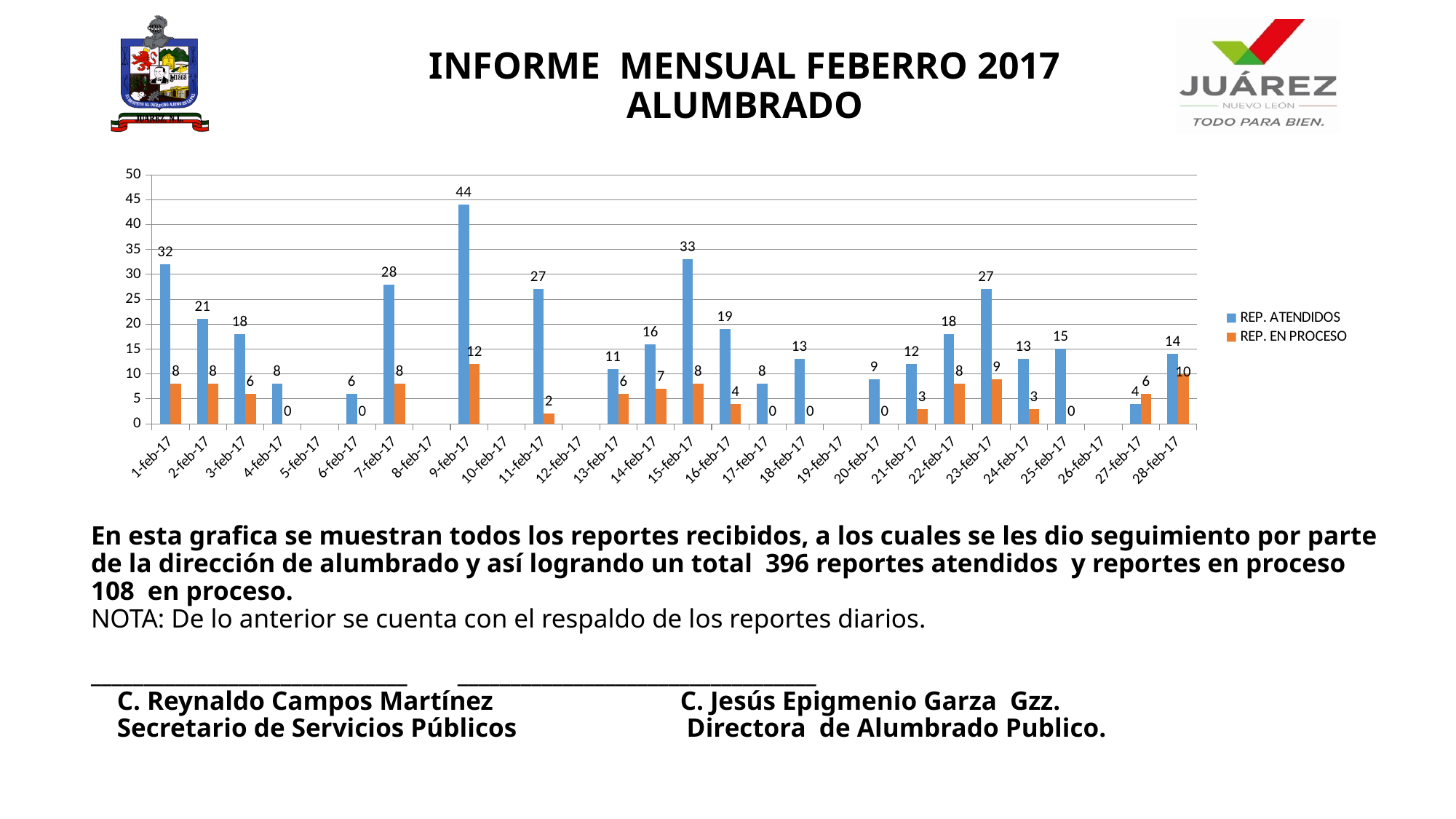
On which date is REP. EN PROCESO highest? 9-feb-17 What is the value of REP. ATENDIDOS on 15-feb-17? 33 What is the difference between REP. ATENDIDOS and REP. EN PROCESO on 1-feb-17? 24 Which is larger on 27-feb-17, REP. ATENDIDOS or REP. EN PROCESO? REP. EN PROCESO What type of chart is shown on the slide? bar chart What is the value of REP. EN PROCESO on 28-feb-17? 10 What colour represents REP. EN PROCESO in the legend? orange Is the value of REP. ATENDIDOS on 7-feb-17 greater or less than 25? greater What is the value of REP. ATENDIDOS on 9-feb-17? 44 On which date is REP. ATENDIDOS highest? 9-feb-17 How many dates are shown on the x axis? 28 How many series does the legend list? 2